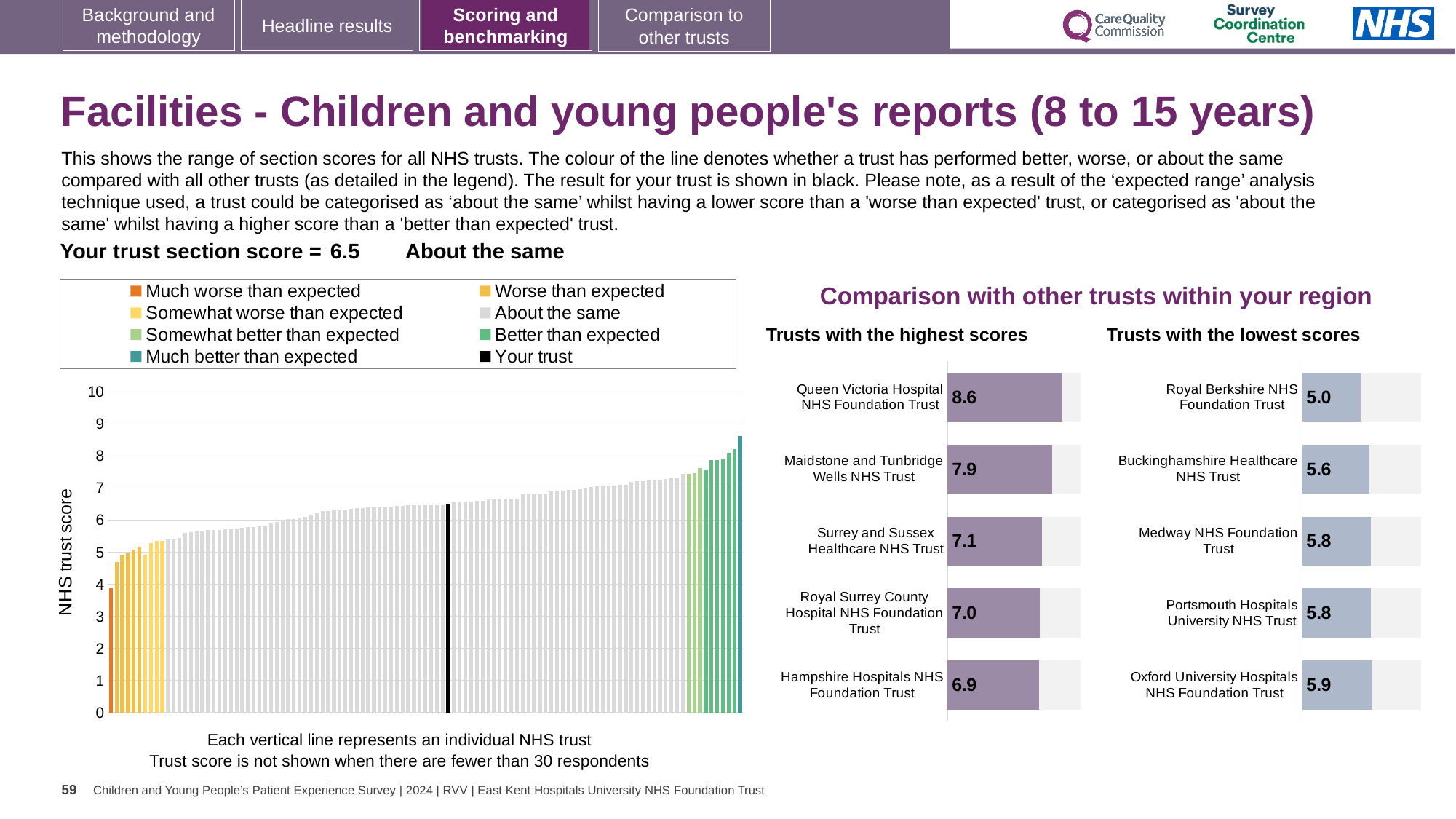
On the 'Trusts with the lowest scores' chart, which has the larger score: Buckinghamshire Healthcare NHS Trust or Medway NHS Foundation Trust? Medway NHS Foundation Trust On the 'Trusts with the lowest scores' chart, how many trusts are shown? 5 On the 'Trusts with the highest scores' chart, which trust has the lowest score? Hampshire Hospitals NHS Foundation Trust On the 'Trusts with the highest scores' chart, what is the difference between the scores of Queen Victoria Hospital NHS Foundation Trust and Maidstone and Tunbridge Wells NHS Trust? 0.7 On the 'Trusts with the lowest scores' chart, what is the score for Royal Berkshire NHS Foundation Trust? 5.0 On the 'Trusts with the lowest scores' chart, which trust has the highest score? Oxford University Hospitals NHS Foundation Trust On the main chart of NHS trust scores on the left, what is the section score for your trust (the black bar)? 6.5 On the main chart of NHS trust scores on the left, is the value of the tallest bar greater or less than 8? greater On the 'Trusts with the highest scores' chart, what is the score for Queen Victoria Hospital NHS Foundation Trust? 8.6 On the 'Trusts with the highest scores' chart, what is the score for Hampshire Hospitals NHS Foundation Trust? 6.9 On the main chart of NHS trust scores on the left, do the bar values rise or fall from left to right? rise How many entries does the legend of the main chart on the left list? 8